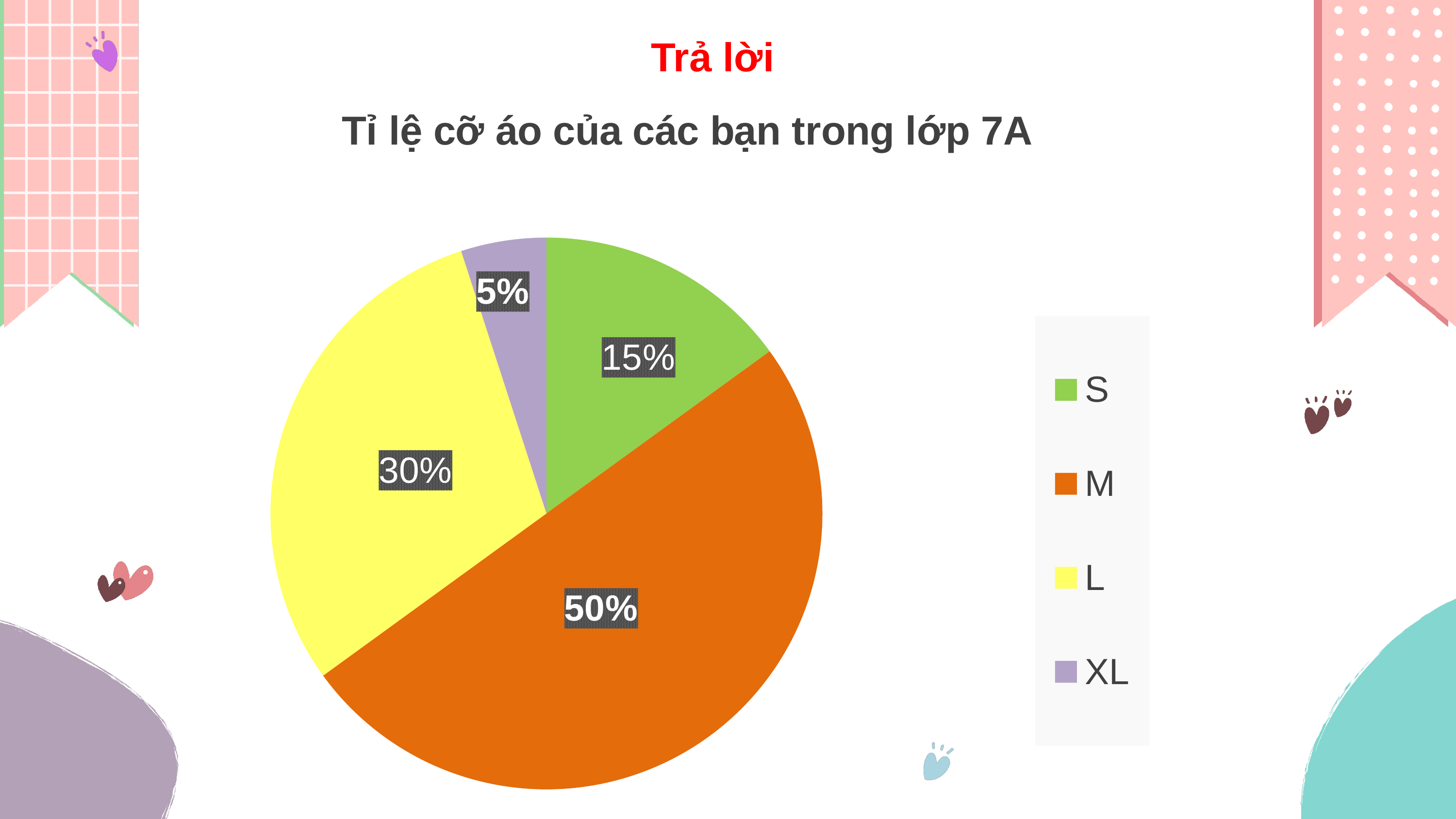
What percentage of the pie does size S take? 15% What percentage of the pie does size XL take? 5% Which has a larger share, size S or size L? L What colour is the slice for size L? yellow Which shirt size has the smallest share of the pie? XL What percentage of the pie does size M take? 50% What is the title of the chart? Tỉ lệ cỡ áo của các bạn trong lớp 7A Which shirt size has the largest share of the pie? M What is the difference in percentage points between size M and size L? 20% How many slices does the pie chart have? 4 What percentage of the pie does size L take? 30% What type of chart is shown on the slide? pie chart